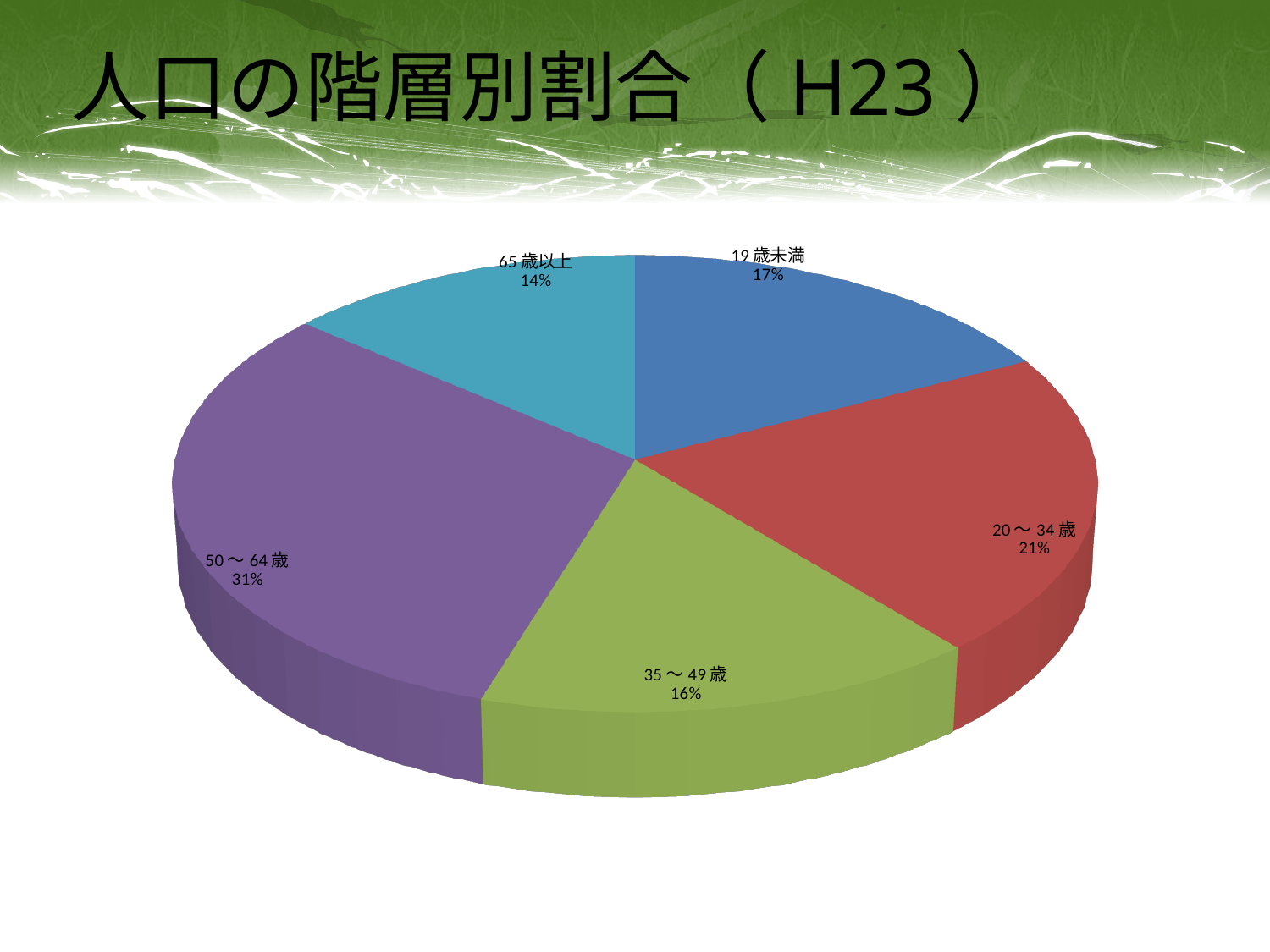
What is the share for 19歳未満? 17% Which age group has the largest share? 50～64歳 What is the share for 50～64歳? 31% What is the share for 35～49歳? 16% What is the share for 20～34歳? 21% What is the difference in percentage points between 50～64歳 and 65歳以上? 17 What is the title of the slide? 人口の階層別割合（H23） Which is larger, the share for 20～34歳 or the share for 35～49歳? 20～34歳 How many age groups are shown in the pie chart? 5 What is the share for 65歳以上? 14% What kind of chart is shown on the slide? pie chart Which age group has the smallest share? 65歳以上